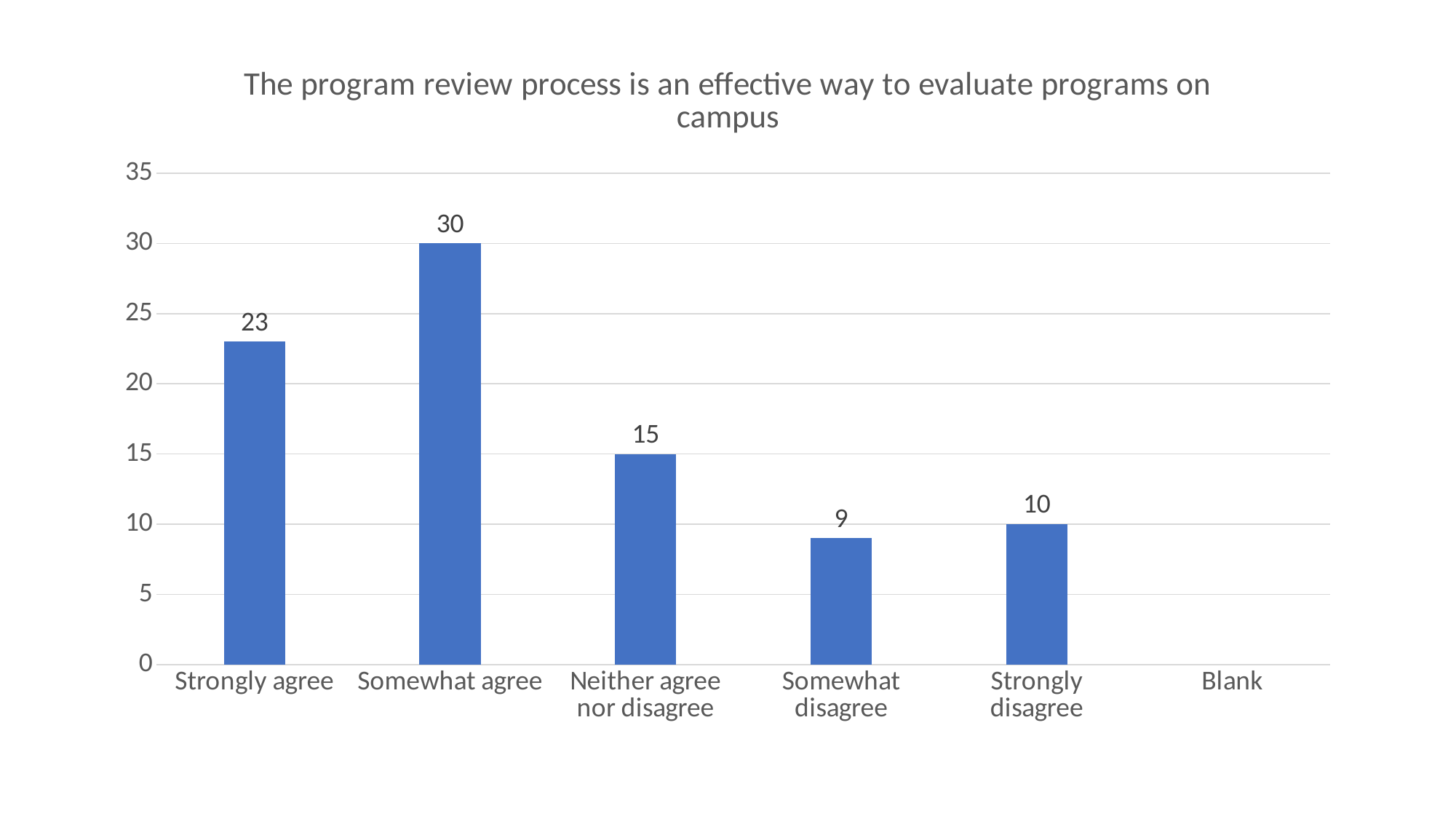
What is the value for Somewhat disagree? 9 What kind of chart is shown on the slide? Bar chart What is the value for Neither agree nor disagree? 15 What is the title of the chart? The program review process is an effective way to evaluate programs on campus What is the difference between the values for Somewhat agree and Strongly agree? 7 Which category has the highest value? Somewhat agree How many categories are shown on the x axis? 6 What is the value for Somewhat agree? 30 What is the value for Strongly agree? 23 Which category with a visible bar has the lowest value? Somewhat disagree Is the value for Strongly agree greater or less than 20? greater Which is larger, the value for Strongly disagree or the value for Somewhat disagree? Strongly disagree